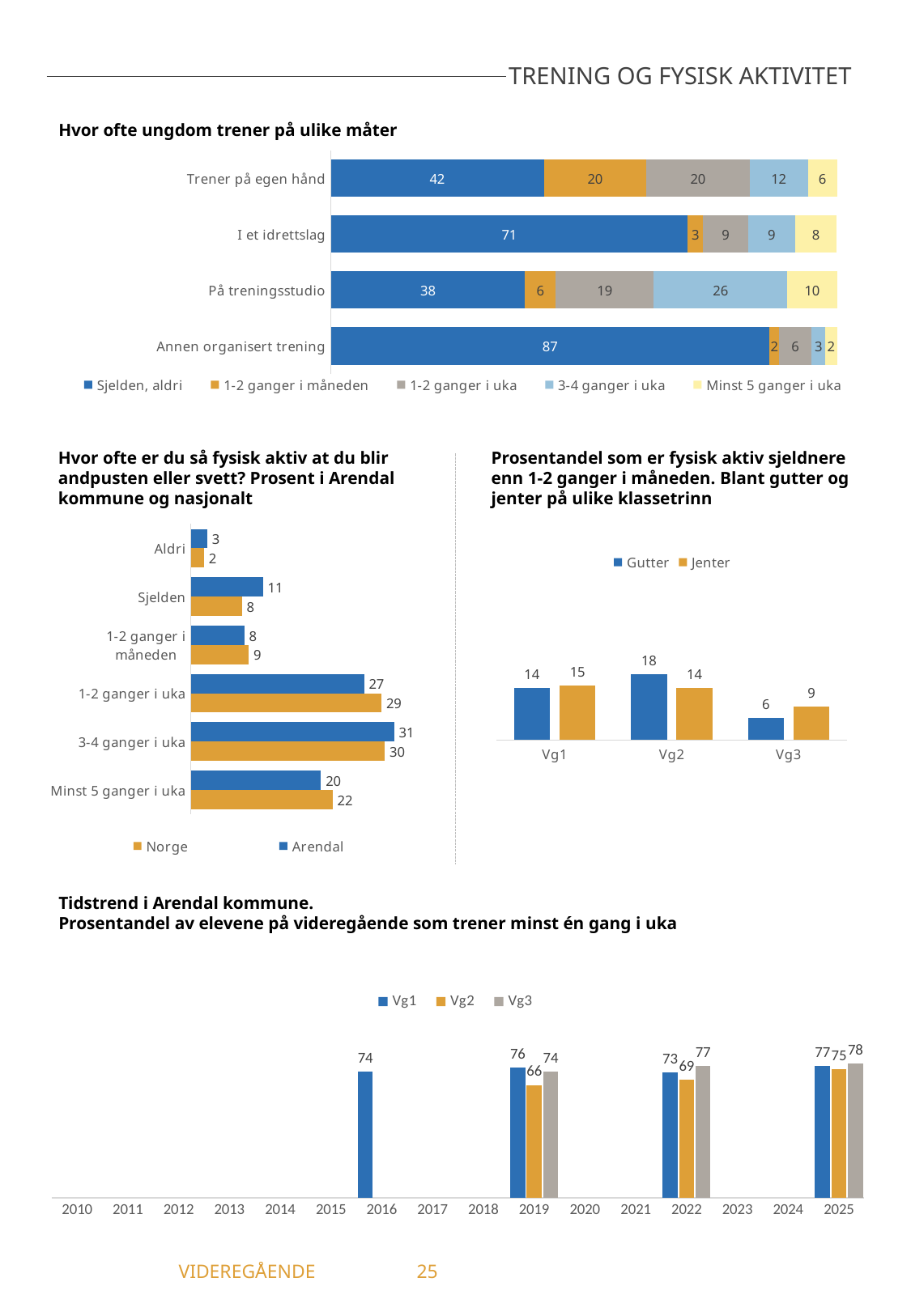
In the chart 'Tidstrend i Arendal kommune', what kind of chart is it? Bar chart In the chart 'Tidstrend i Arendal kommune', what is the Vg2 value for 2019? 66 In the chart 'Hvor ofte ungdom trener på ulike måter', what is the value for 'Sjelden, aldri' in the 'På treningsstudio' bar? 38 In the chart 'Hvor ofte ungdom trener på ulike måter', what is the total of the 'Trener på egen hånd' stacked bar? 100 In the chart 'Hvor ofte ungdom trener på ulike måter', how many series does the legend list? 5 In the chart 'Hvor ofte er du så fysisk aktiv at du blir andpusten eller svett?', what is the difference between the Norge and Arendal values for 'Sjelden'? 3 In the chart 'Hvor ofte er du så fysisk aktiv at du blir andpusten eller svett?', how many categories are shown? 6 In the chart 'Tidstrend i Arendal kommune', which year has the lowest Vg3 value? 2019 In the chart 'Hvor ofte ungdom trener på ulike måter', which category has the highest 'Sjelden, aldri' value? Annen organisert trening In the chart 'Prosentandel som er fysisk aktiv sjeldnere enn 1-2 ganger i måneden', what is the value for Jenter in Vg3? 9 In the chart 'Hvor ofte er du så fysisk aktiv at du blir andpusten eller svett?', what is the Arendal value for '3-4 ganger i uka'? 31 In the chart 'Prosentandel som er fysisk aktiv sjeldnere enn 1-2 ganger i måneden', which is larger in Vg2, Gutter or Jenter? Gutter